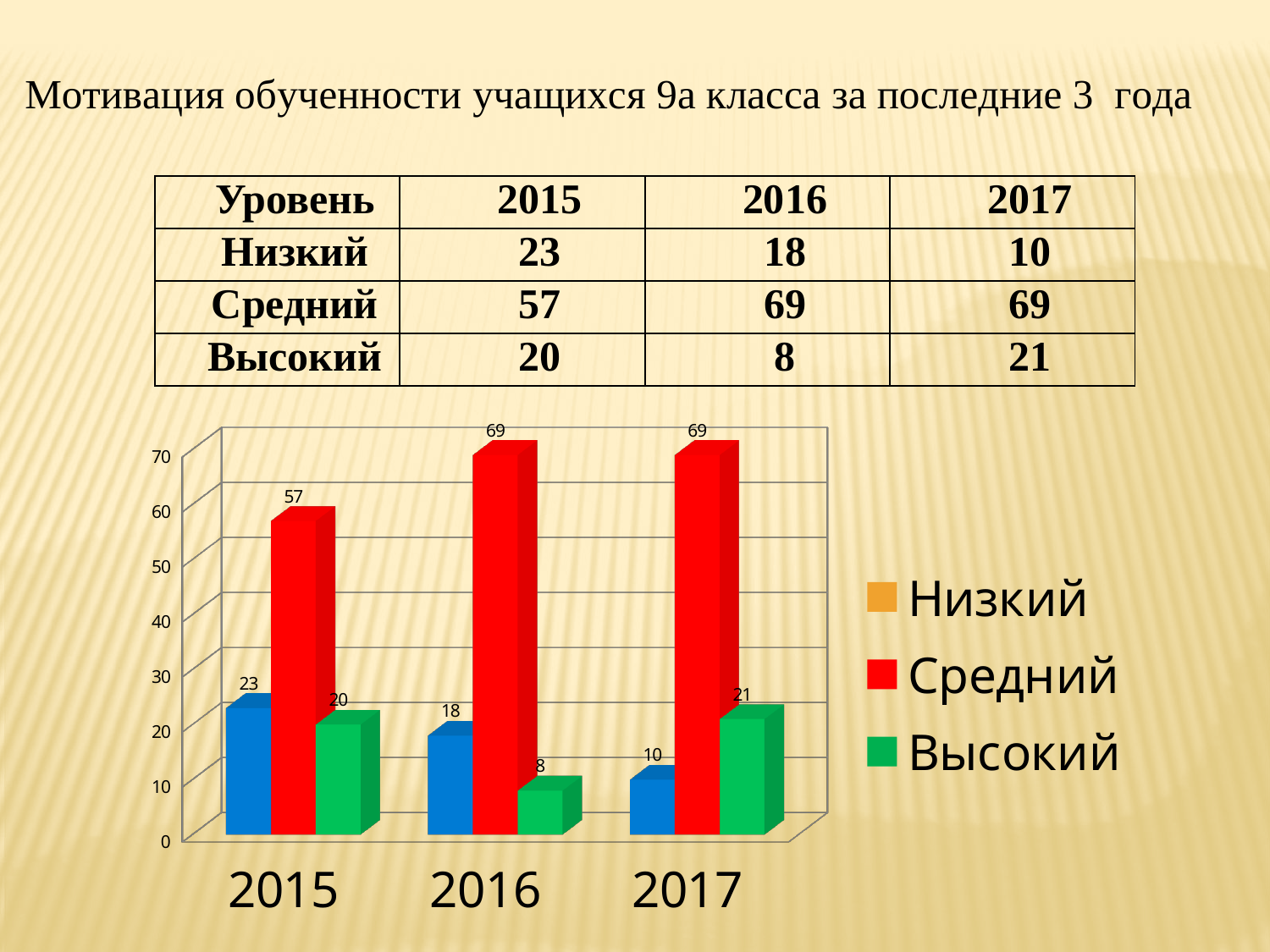
What kind of chart is shown? bar chart What is the difference between the Средний values for 2016 and 2015? 12 Which year has the lowest value for Высокий? 2016 What is the value for Низкий in 2017? 10 Which is larger in 2017: the value for Низкий or the value for Высокий? Высокий How many series does the legend list? 3 Which year has the highest value for Низкий? 2015 Does the value for Низкий rise or fall from 2015 to 2017? fall What is the value for Высокий in 2016? 8 What colour are the bars for Средний? red What is the value for Средний in 2015? 57 How many years are shown on the x axis? 3